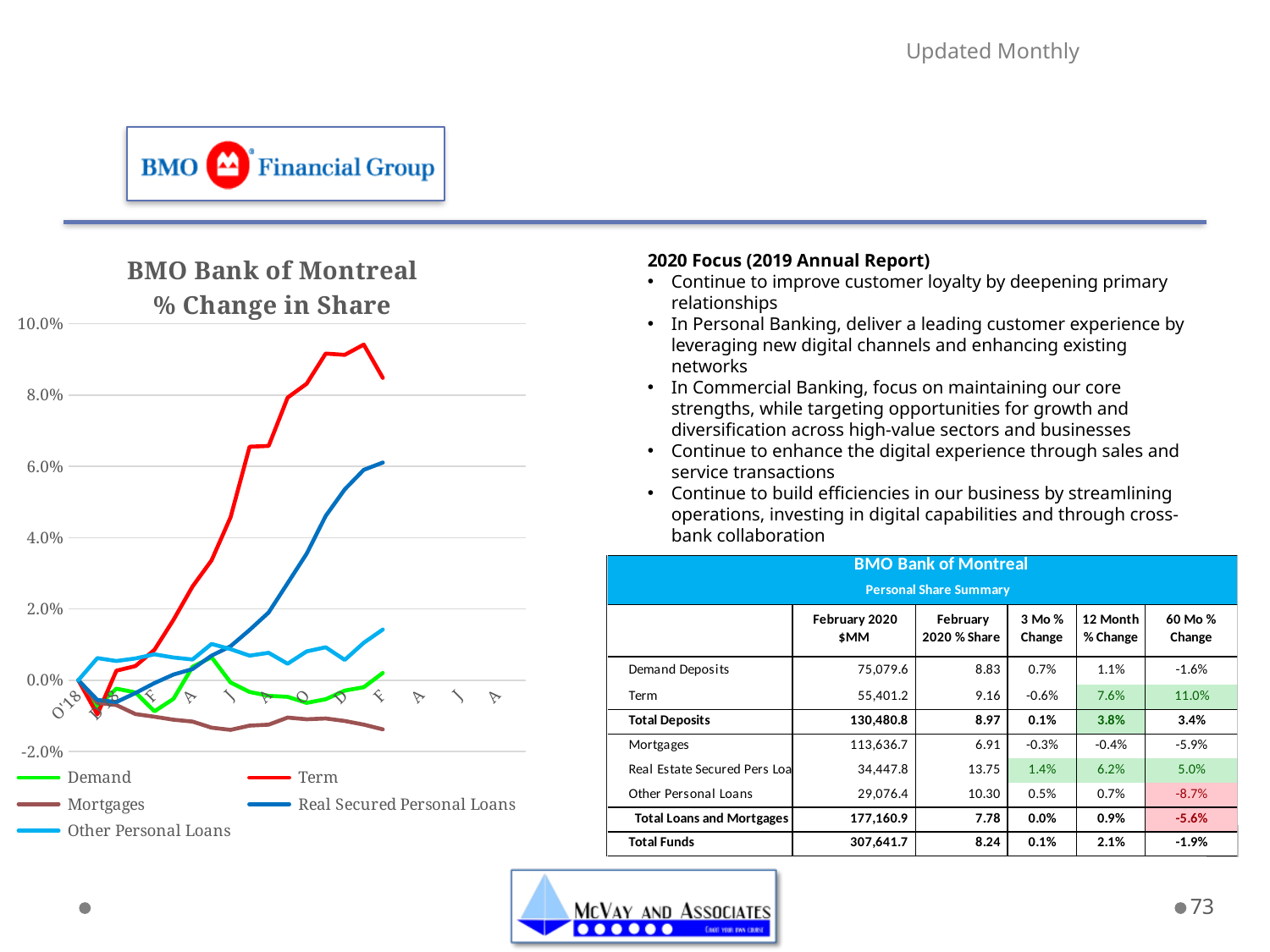
What colour is the line for the Term series? red What kind of chart is shown on the slide? line chart Which series has the lowest value at the end of the plotted period? Mortgages How many series does the legend of the chart list? 5 Does the Mortgages series generally rise or fall across the plotted period? fall Is the peak value of the Term series greater or less than 8.0%? greater Is the final plotted value of the Real Secured Personal Loans series greater or less than 4.0%? greater Is the final plotted value of the Mortgages series greater or less than 0.0%? less At the end of the plotted period, which is larger: the Term series or the Demand series? Term What is the title of the chart? BMO Bank of Montreal % Change in Share Which series reaches the highest value on the chart? Term Does the Term series generally rise or fall across the plotted period? rise